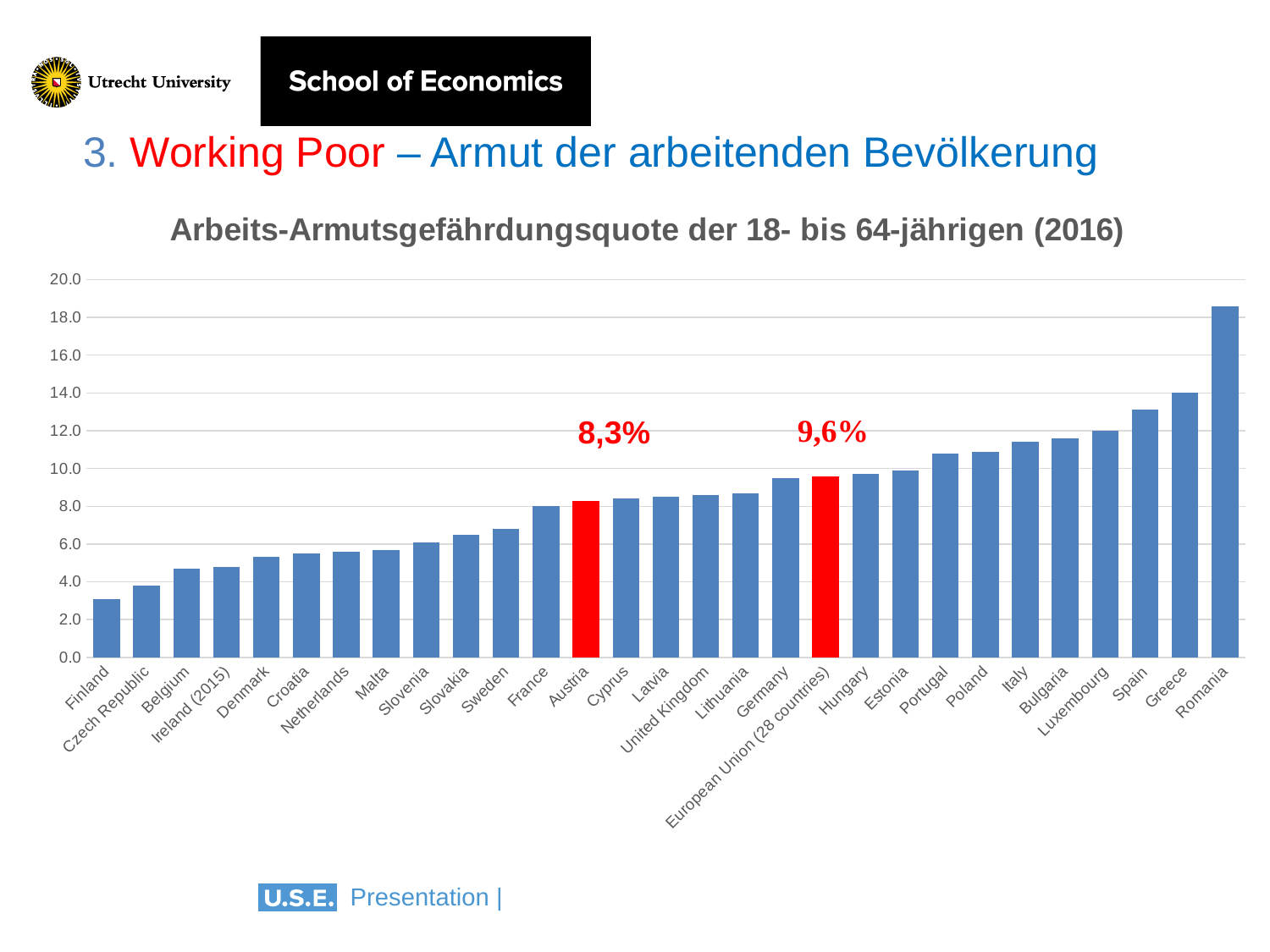
Which country has the highest bar in the chart? Romania By how many percentage points does the European Union (28 countries) value exceed the Austria value? 1,3 Is the value for Romania greater or less than 18.0? greater Is the value for Italy greater or less than 10.0? greater Do the values rise or fall from left to right along the x axis? Rise What kind of chart is shown on the slide? Bar chart Which country has the lowest bar in the chart? Finland Which has the larger value, Greece or Spain? Greece Is the value for Finland greater or less than 4.0? less What is the value shown for Austria? 8,3% What is the value shown for European Union (28 countries)? 9,6% How many countries or regions are shown on the x axis of the chart? 29